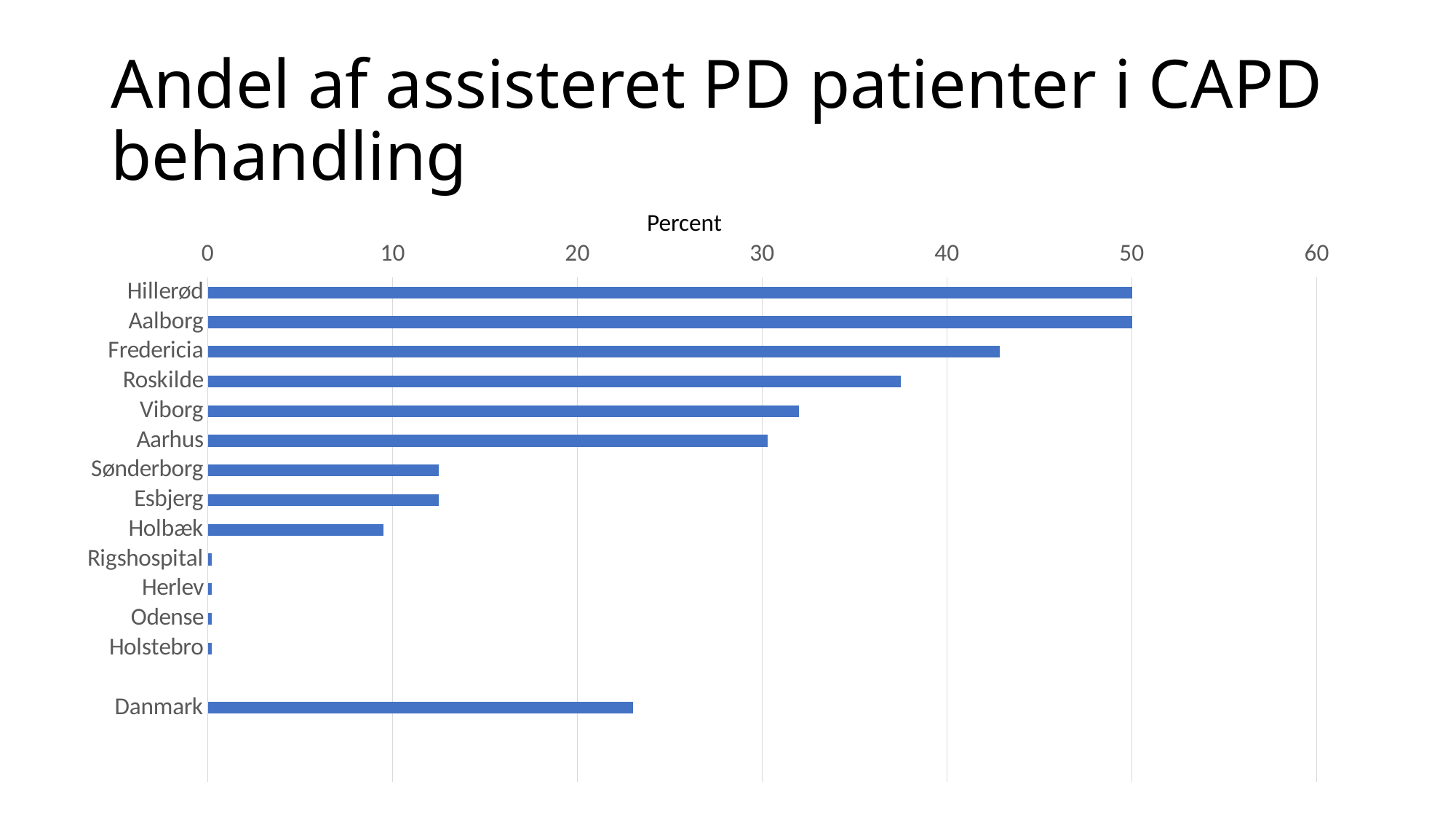
What is the value for Aalborg? 50 Is the value for Danmark greater or less than 20? greater Is the value for Holbæk greater or less than 10? less What is the title of the value axis? Percent Is the value for Viborg greater or less than 30? greater Which has a larger value, Fredericia or Roskilde? Fredericia What kind of chart is shown on the slide? Bar chart Which has a larger value, Danmark or Aarhus? Aarhus How many categories are shown on the chart? 14 What is the value for Hillerød? 50